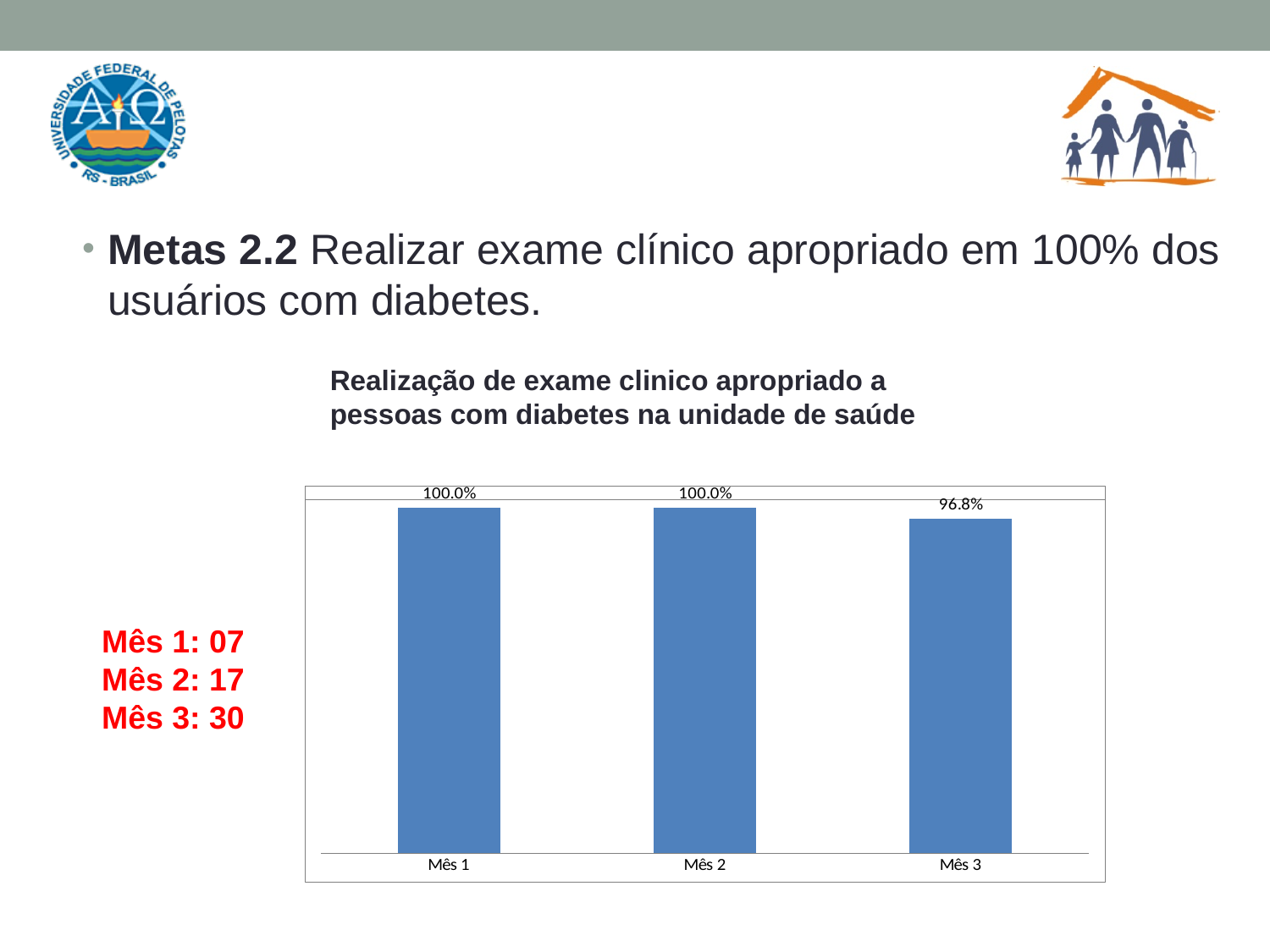
How many months are shown on the x axis? 3 What is the title of the chart? Realização de exame clinico apropriado a pessoas com diabetes na unidade de saúde Which is larger, the value for Mês 2 or the value for Mês 3? Mês 2 What colour are the bars in the chart? Blue What kind of chart is shown on the slide? Bar chart What is the value for Mês 2? 100.0% What is the value for Mês 3? 96.8% What is the value for Mês 1? 100.0% Do the values rise or fall from Mês 2 to Mês 3? Fall Do Mês 1 and Mês 2 have the same value? Yes Which month has the lowest value? Mês 3 What is the difference between the values for Mês 1 and Mês 3? 3.2%